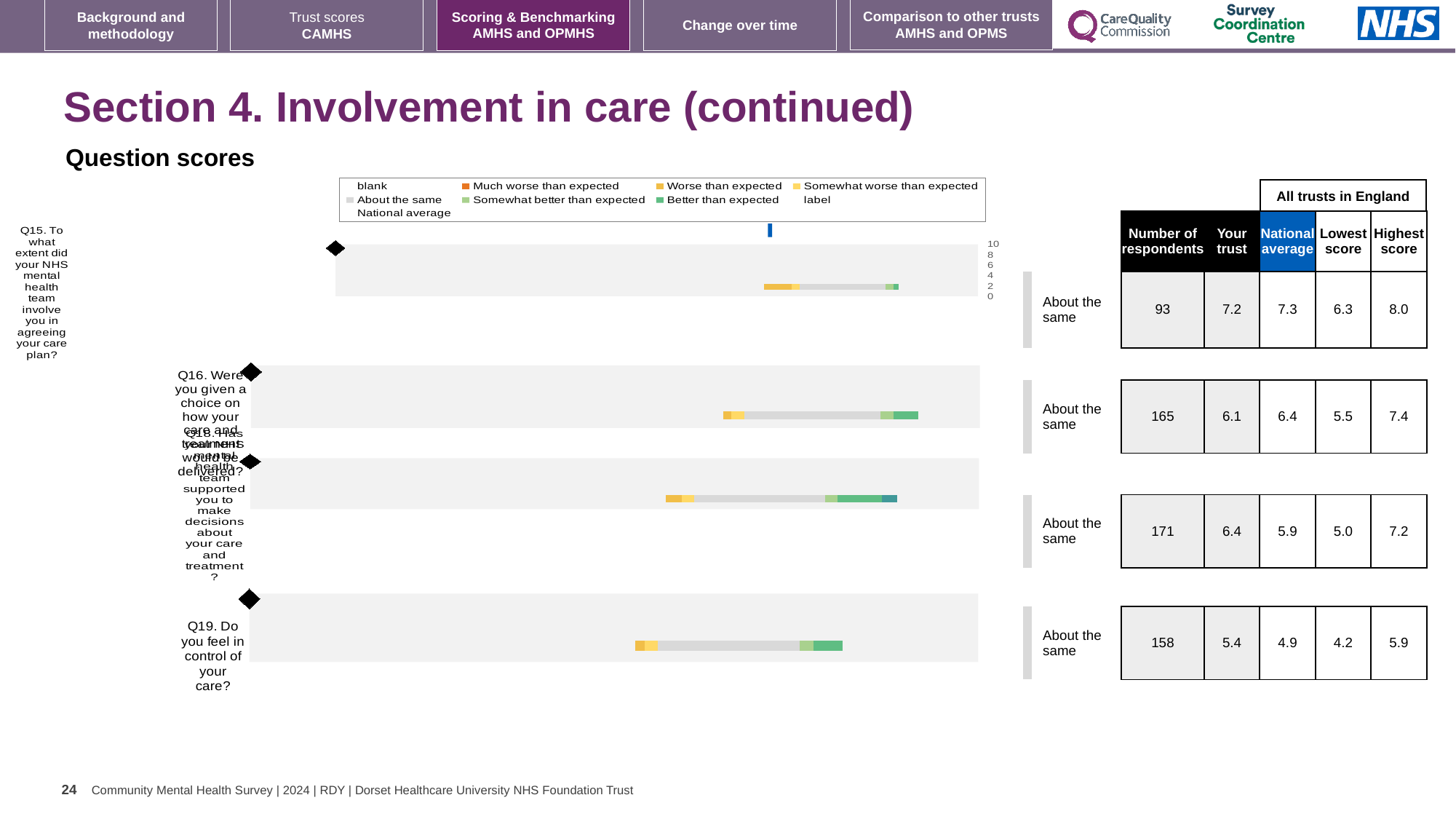
What is the lowest score across all trusts in England for Q15? 6.3 What is the number of respondents for Q15 (involving you in agreeing your care plan)? 93 What kind of chart is used to show the question scores on this slide? bar chart Which question has the highest number of respondents? Q18 What benchmark category is shown for all four questions on this slide? About the same What is the difference between the 'Your trust' score and the national average for Q18? 0.5 Which question has the lowest 'Your trust' score? Q19 What is the highest score across all trusts in England for Q19 (feeling in control of your care)? 5.9 What is the national average score for Q18 (supported to make decisions about care and treatment)? 5.9 What is the 'Your trust' score for Q16 (choice on how care and treatment would be delivered)? 6.1 For Q16, which is larger: the 'Your trust' score or the national average? National average How many questions are plotted in the question scores chart? 4